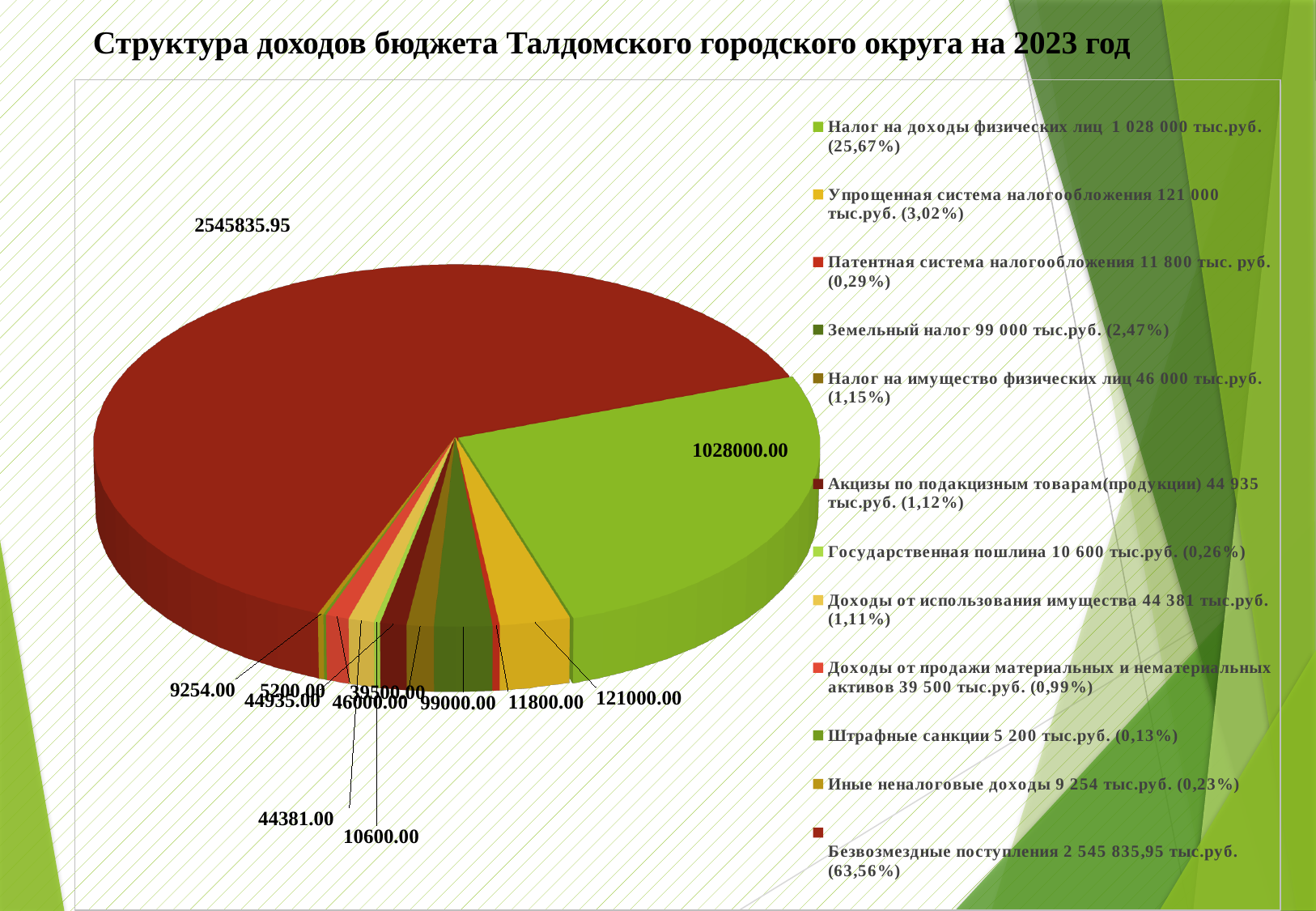
What is the data label value for the slice 'Налог на доходы физических лиц'? 1028000.00 What is the data label value for the slice 'Штрафные санкции'? 5200.00 What is the title of the chart? Структура доходов бюджета Талдомского городского округа на 2023 год What is the data label value for the slice 'Безвозмездные поступления'? 2545835.95 How many slices does the pie chart have? 12 What share of the pie does 'Безвозмездные поступления' represent, according to the legend? 63,56% What is the data label value for the slice 'Земельный налог'? 99000.00 Which category has the largest slice of the pie? Безвозмездные поступления What kind of chart is shown on the slide? Pie chart Which is larger: the value for 'Упрощенная система налогообложения' or the value for 'Земельный налог'? Упрощенная система налогообложения Which category has the smallest slice of the pie? Штрафные санкции What share of the pie does 'Упрощенная система налогообложения' represent, according to the legend? 3,02%